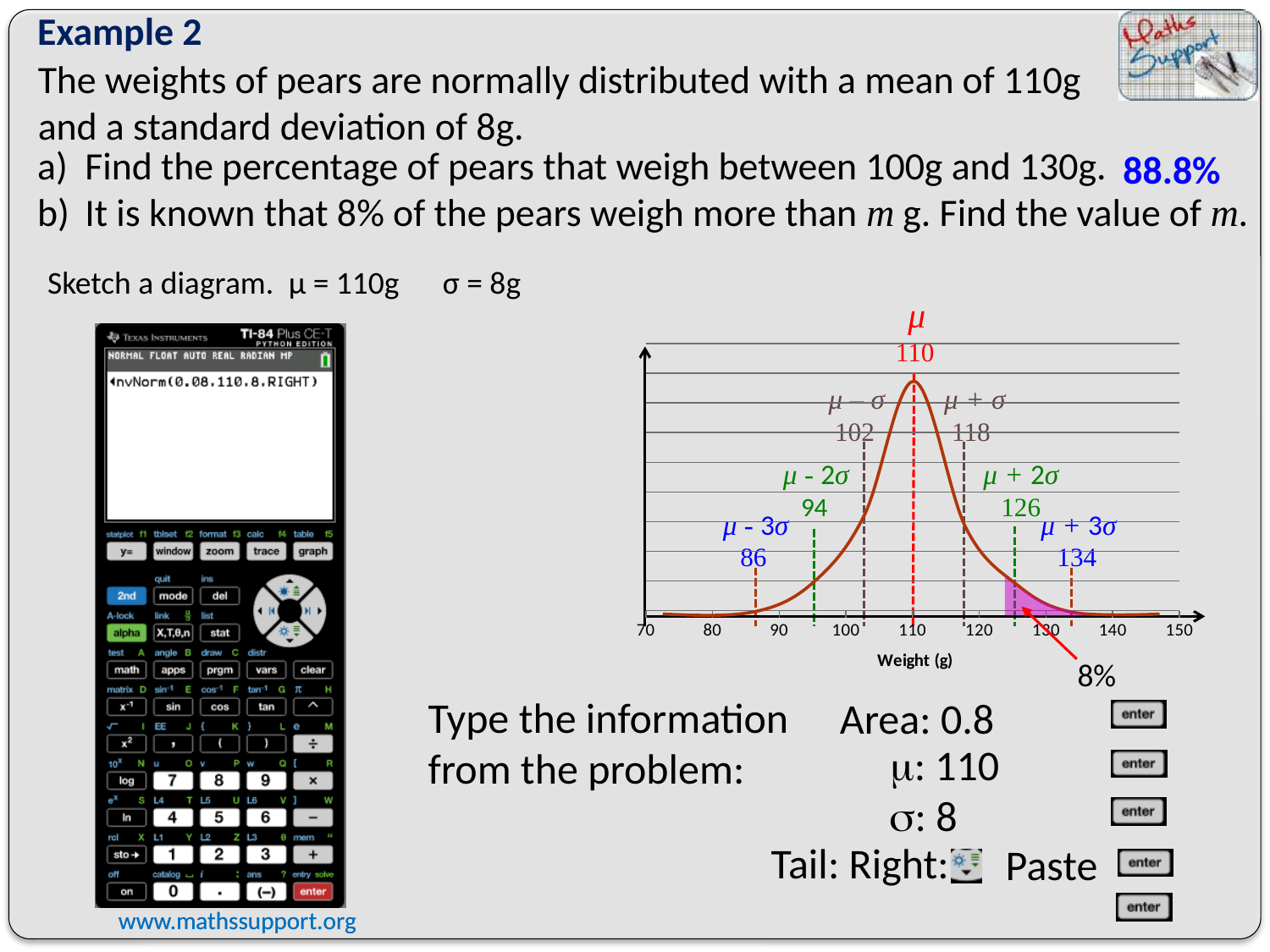
What weight value is marked at μ on the diagram? 110 How many dashed vertical lines mark σ positions (including μ) on the diagram? 7 What is the x-axis label of the normal distribution diagram? Weight (g) What weight value is marked at μ + σ on the diagram? 118 What weight value is marked at μ − 3σ on the diagram? 86 What weight value is marked at μ − 2σ on the diagram? 94 What weight value is marked at μ + 2σ on the diagram? 126 What is the lowest tick value shown on the x-axis of the diagram? 70 What is the highest tick value shown on the x-axis of the diagram? 150 What percentage is labelled for the shaded region in the right tail of the diagram? 8% What is the difference between the weights marked at μ + 3σ and μ − 3σ on the diagram? 48 Which is larger on the diagram, the weight marked at μ + σ or the weight marked at μ − σ? μ + σ